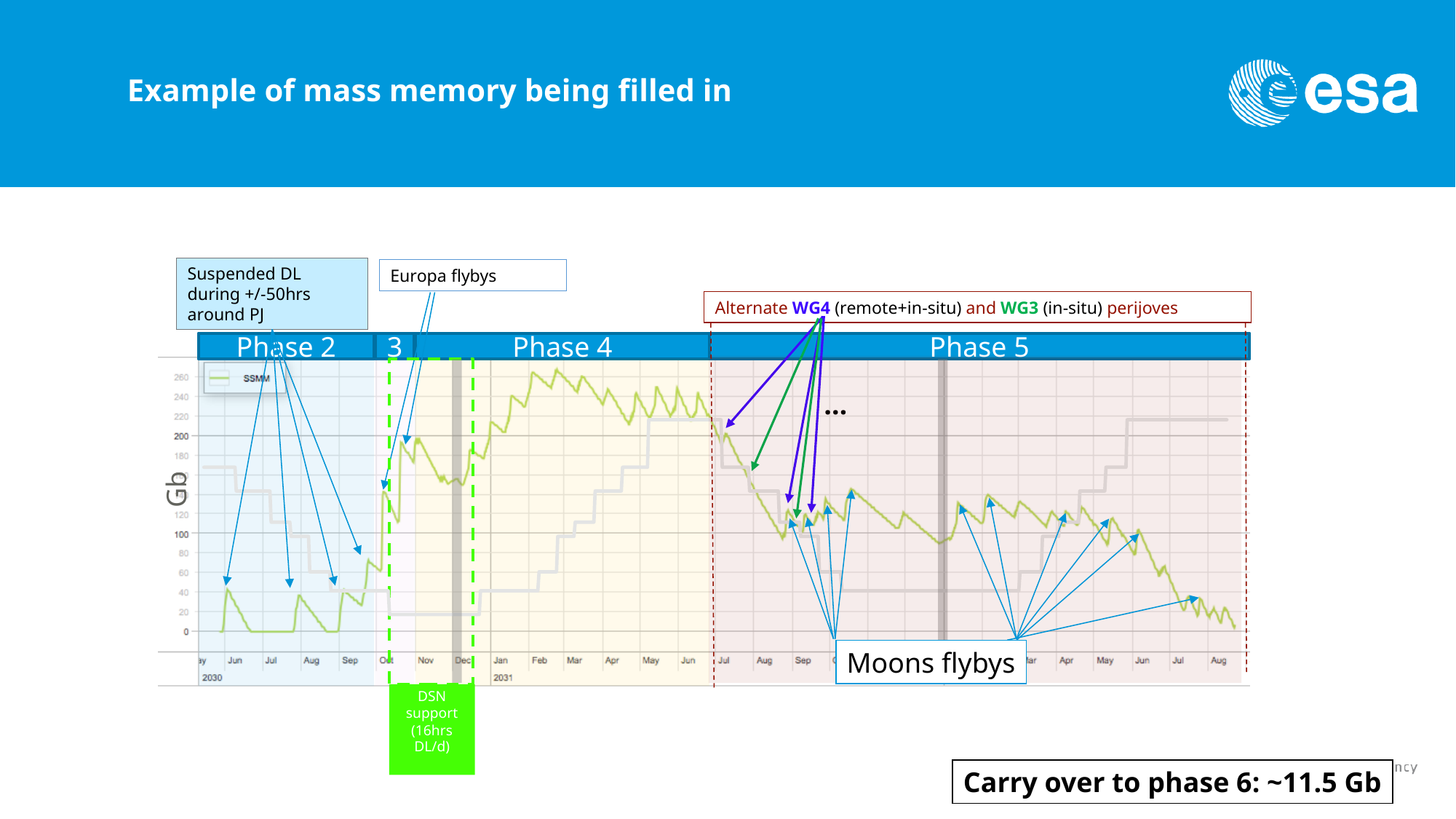
What series name does the chart legend list? SSMM Is the SSMM value at the start of Phase 5 (Jul 2031) greater or less than 160? greater What kind of chart is shown on the slide? line chart What unit is shown on the y axis of the chart? Gb What is the SSMM value at the very start of the chart in May 2030? 0 Is the SSMM value at the end of the chart in Aug 2032 greater or less than 40? less Is the highest SSMM value reached in Phase 4 greater or less than 220? greater What is the highest tick value shown on the y axis? 260 Does the SSMM value generally rise or fall across Phase 5? fall Which is larger, the peak SSMM value in Phase 2 or the peak SSMM value in Phase 4? Phase 4 In which phase does the SSMM line reach its highest value? Phase 4